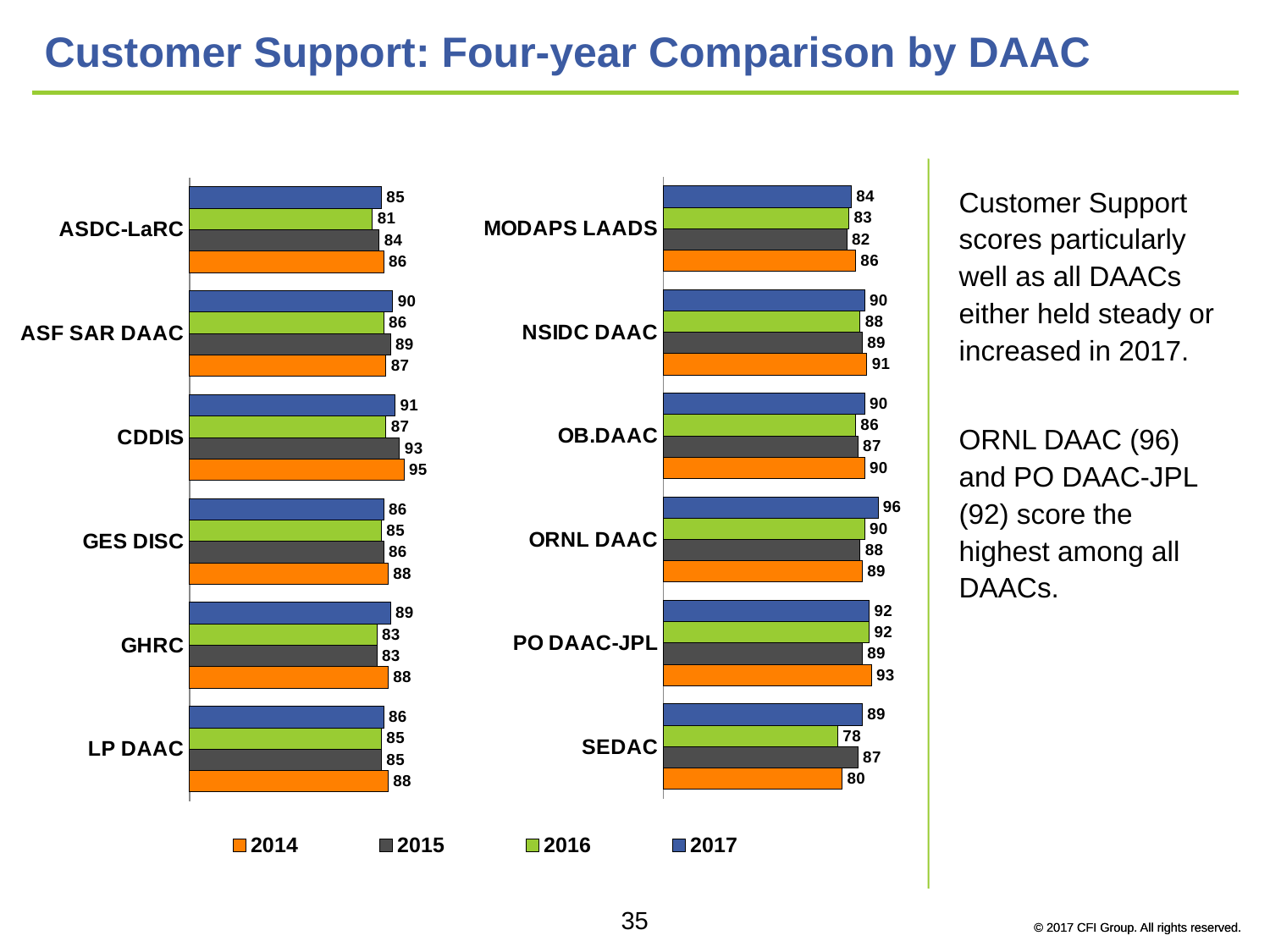
How many DAACs are shown in the right chart? 6 In the left chart, which DAAC has the lowest 2016 score? ASDC-LaRC In the left chart, what is the 2017 Customer Support score for CDDIS? 91 In the left chart, what is the 2014 score for GHRC? 88 In the right chart, what is the 2015 score for PO DAAC-JPL? 89 In the left chart, which is larger for ASF SAR DAAC: the 2017 score or the 2014 score? 2017 score In the right chart, what is the 2016 score for SEDAC? 78 What kind of chart is used on this slide? Bar chart Which colour represents 2014 in the legend? Orange In the right chart, what is the difference between the 2017 and 2016 scores for SEDAC? 11 In the right chart, which DAAC has the highest 2017 score? ORNL DAAC How many series does the legend list? 4